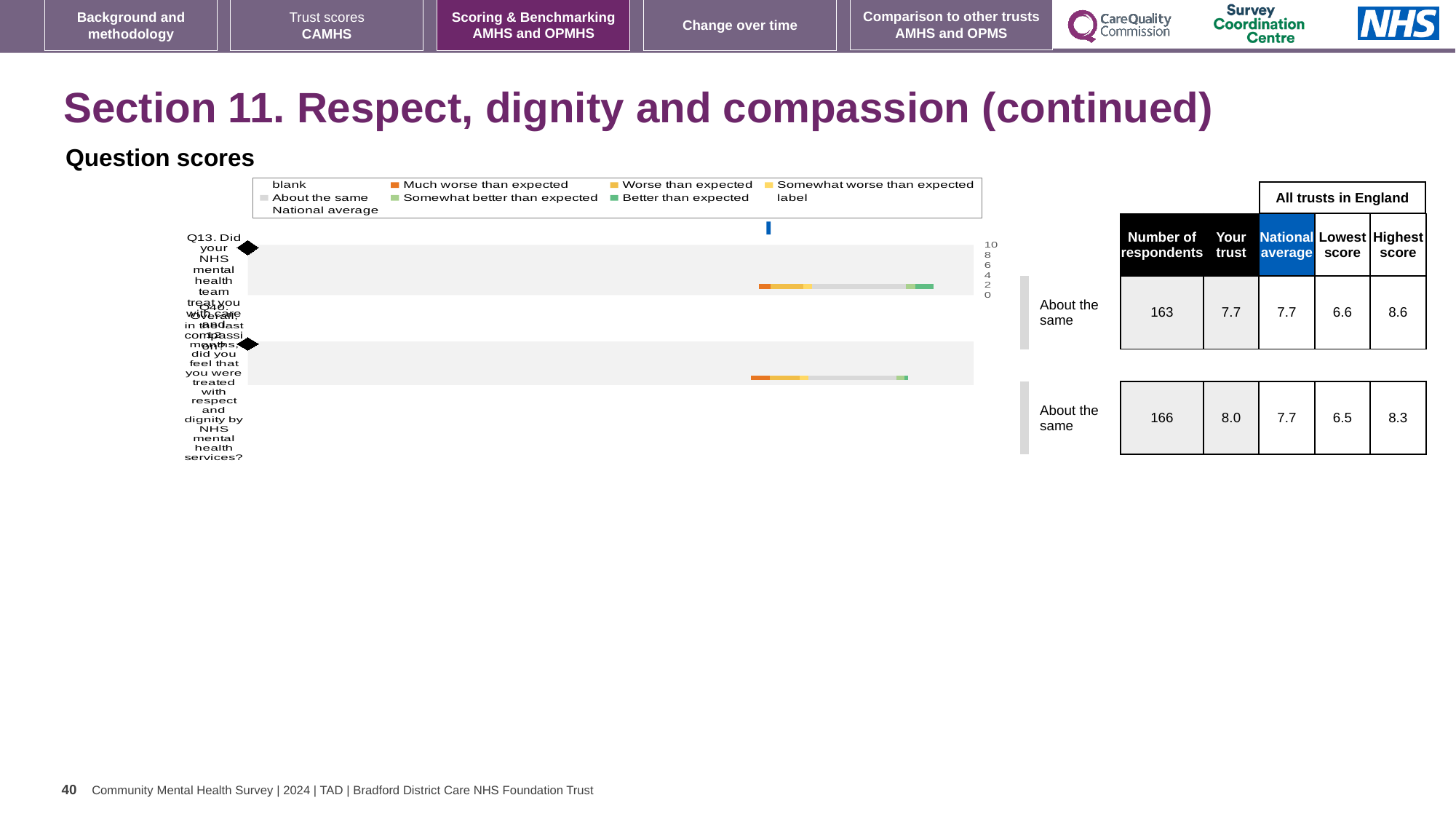
What is the 'Your trust' score for Q10 in the table beside the chart? 8.0 What is the lowest score across all trusts in England for Q10? 6.5 How many more respondents answered Q10 than Q13? 3 What is the highest score across all trusts in England for Q13? 8.6 What is the number of respondents for Q13 in the table beside the chart? 163 What colour does the legend use for 'Much worse than expected'? orange How many questions are plotted in the 'Question scores' chart? 2 What kind of chart is shown under 'Question scores'? bar chart What is the difference between the highest and lowest scores for Q13? 2.0 What is the national average score for Q13 in the table beside the chart? 7.7 What colour does the legend use for 'Better than expected'? green For Q10, which is larger: the 'Your trust' score or the national average? Your trust